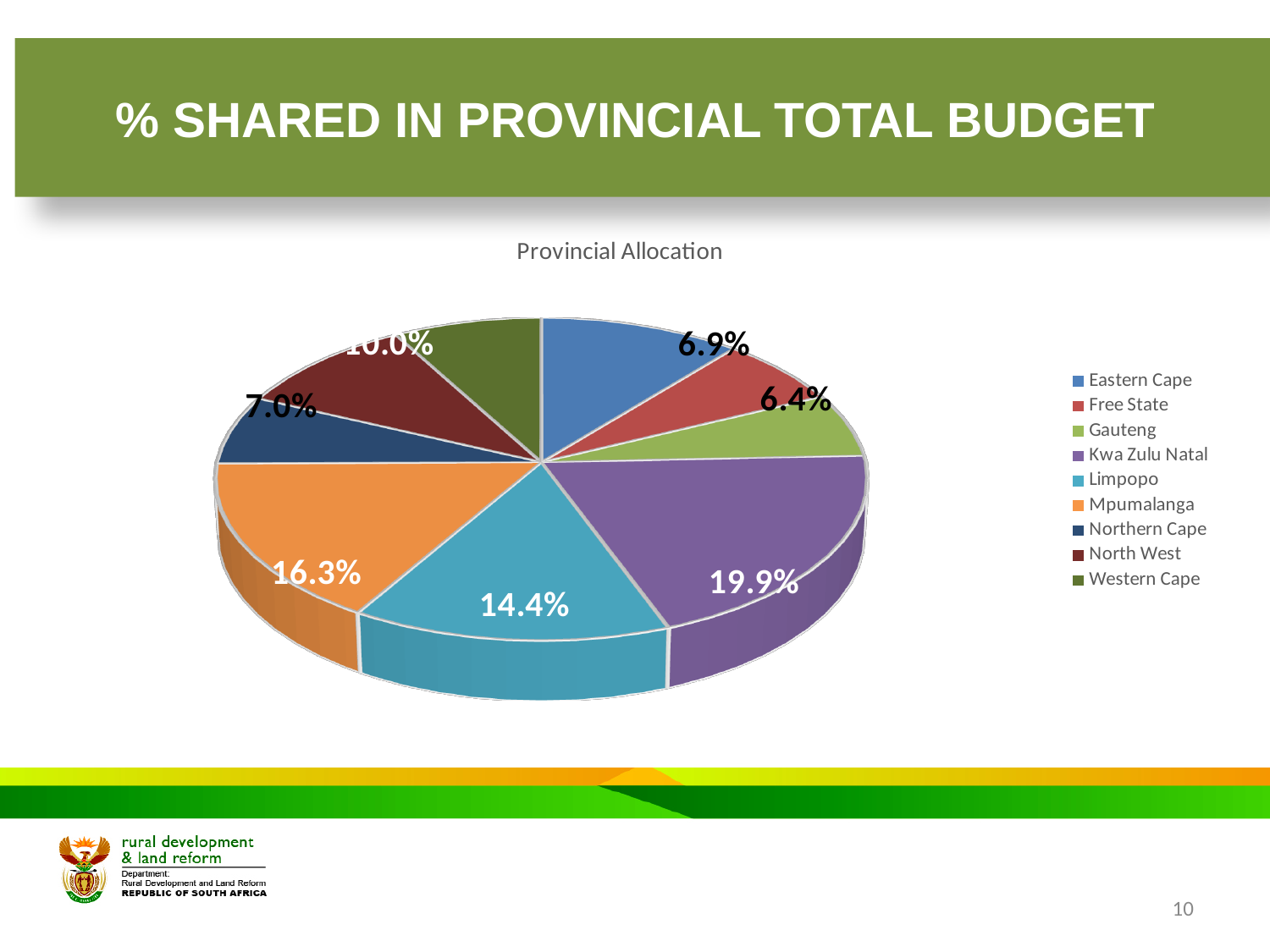
What share of the provincial allocation does Limpopo have? 14.4% What is the chart's title? Provincial Allocation What share of the provincial allocation does Free State have? 6.9% What type of chart is shown on the slide? Pie chart How many provinces are listed in the legend of the pie chart? 9 What share of the provincial allocation does Mpumalanga have? 16.3% What share of the provincial allocation does Northern Cape have? 7.0% Which has the larger share of the provincial allocation, Mpumalanga or Limpopo? Mpumalanga What share of the provincial allocation does Kwa Zulu Natal have? 19.9% What is the difference in percentage points between Kwa Zulu Natal's share and Limpopo's share? 5.5 Which province has the largest share of the provincial allocation? Kwa Zulu Natal